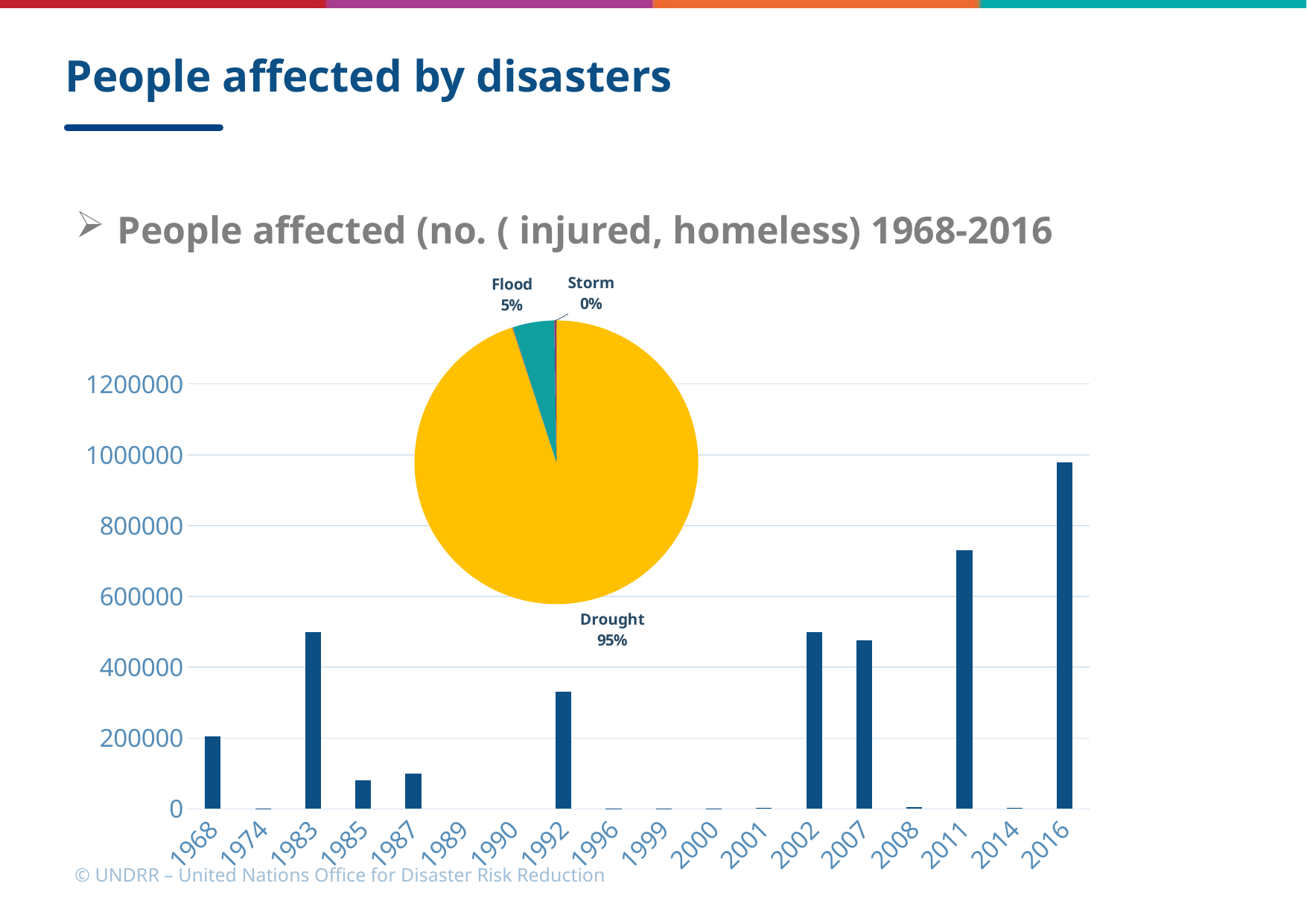
In the pie chart, what share is shown for Storm? 0% In the pie chart, how many percentage points larger is the Drought share than the Flood share? 90% In the pie chart, what share of people affected is attributed to Flood? 5% In the bar chart of people affected by year, how many years are shown on the x axis? 18 In the bar chart of people affected by year, which year has the larger value, 2011 or 2016? 2016 In the bar chart of people affected by year, is the value for 2016 greater or less than 800000? greater In the bar chart of people affected by year, which year has the highest bar? 2016 In the bar chart of people affected by year, is the value for 1968 greater or less than 400000? less In the pie chart, which disaster type has the largest share? Drought What kind of chart is the lower chart showing people affected by year? Bar chart In the pie chart, what share of people affected is attributed to Drought? 95%